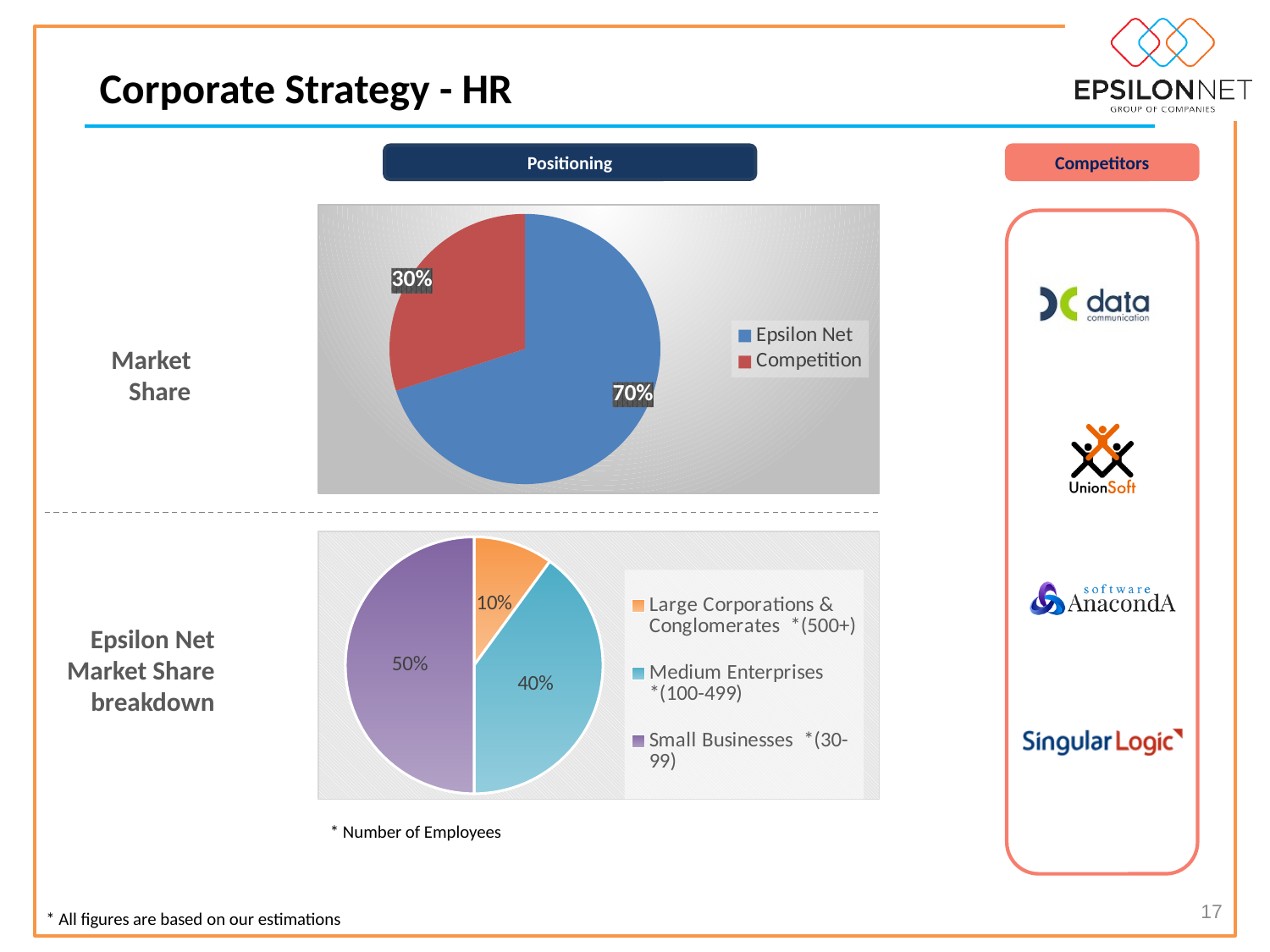
What type of chart is the Market Share chart? Pie chart In the Epsilon Net Market Share breakdown chart, what colour is the Medium Enterprises slice? Teal/light blue In the Market Share pie chart, what share does Competition hold? 30% How many categories are shown in the Epsilon Net Market Share breakdown pie chart? 3 How many entries does the legend of the Market Share chart list? 2 In the Epsilon Net Market Share breakdown chart, which category has the smallest share? Large Corporations & Conglomerates (500+) In the Market Share pie chart, which slice is larger, Epsilon Net or Competition? Epsilon Net In the Epsilon Net Market Share breakdown chart, which category has the largest share? Small Businesses (30-99) In the Epsilon Net Market Share breakdown chart, what share do Medium Enterprises (100-499 employees) represent? 40% In the Epsilon Net Market Share breakdown chart, what share do Small Businesses (30-99 employees) represent? 50% In the Market Share pie chart, what is the difference between the Epsilon Net share and the Competition share? 40% In the Market Share pie chart, what share does Epsilon Net hold? 70%